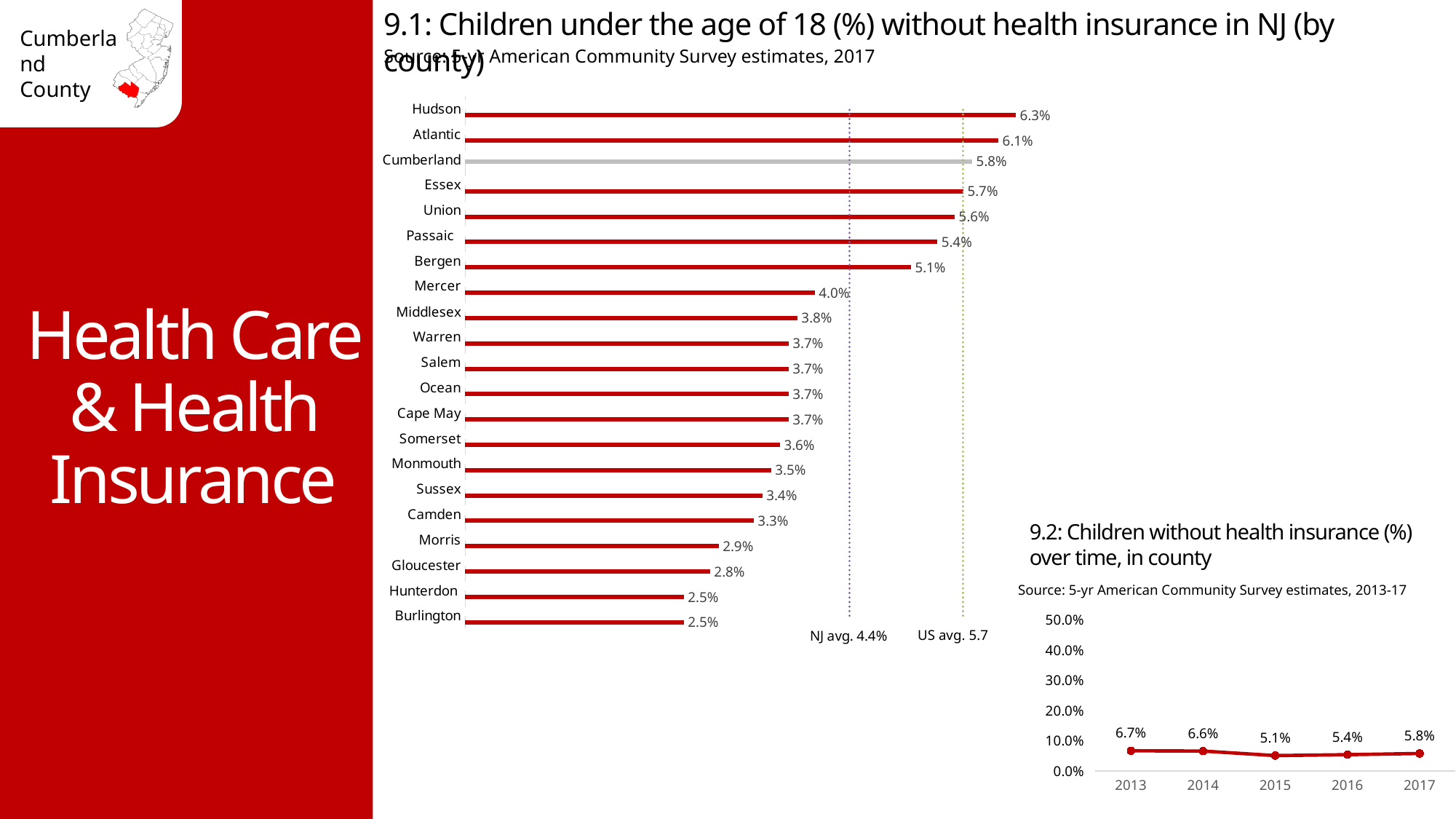
In chart 9.1, what is the difference between Hudson and Atlantic? 0.2% In chart 9.1, what percentage of children under 18 in Cumberland County are without health insurance? 5.8% In chart 9.2, which year has the highest value? 2013 In chart 9.1, which is larger, the value for Mercer or the value for Camden? Mercer In chart 9.1, which county has the highest percentage of children without health insurance? Hudson In chart 9.2, which year has the lowest value? 2015 What kind of chart is chart 9.1? Bar chart In chart 9.1, how many counties are shown? 21 In chart 9.1, what is the NJ average shown by the dotted line? 4.4% In chart 9.1, what is the value for Bergen? 5.1% In chart 9.2, what is the difference between the 2013 and 2017 values? 0.9% In chart 9.2, what was the percentage of children without health insurance in 2015? 5.1%